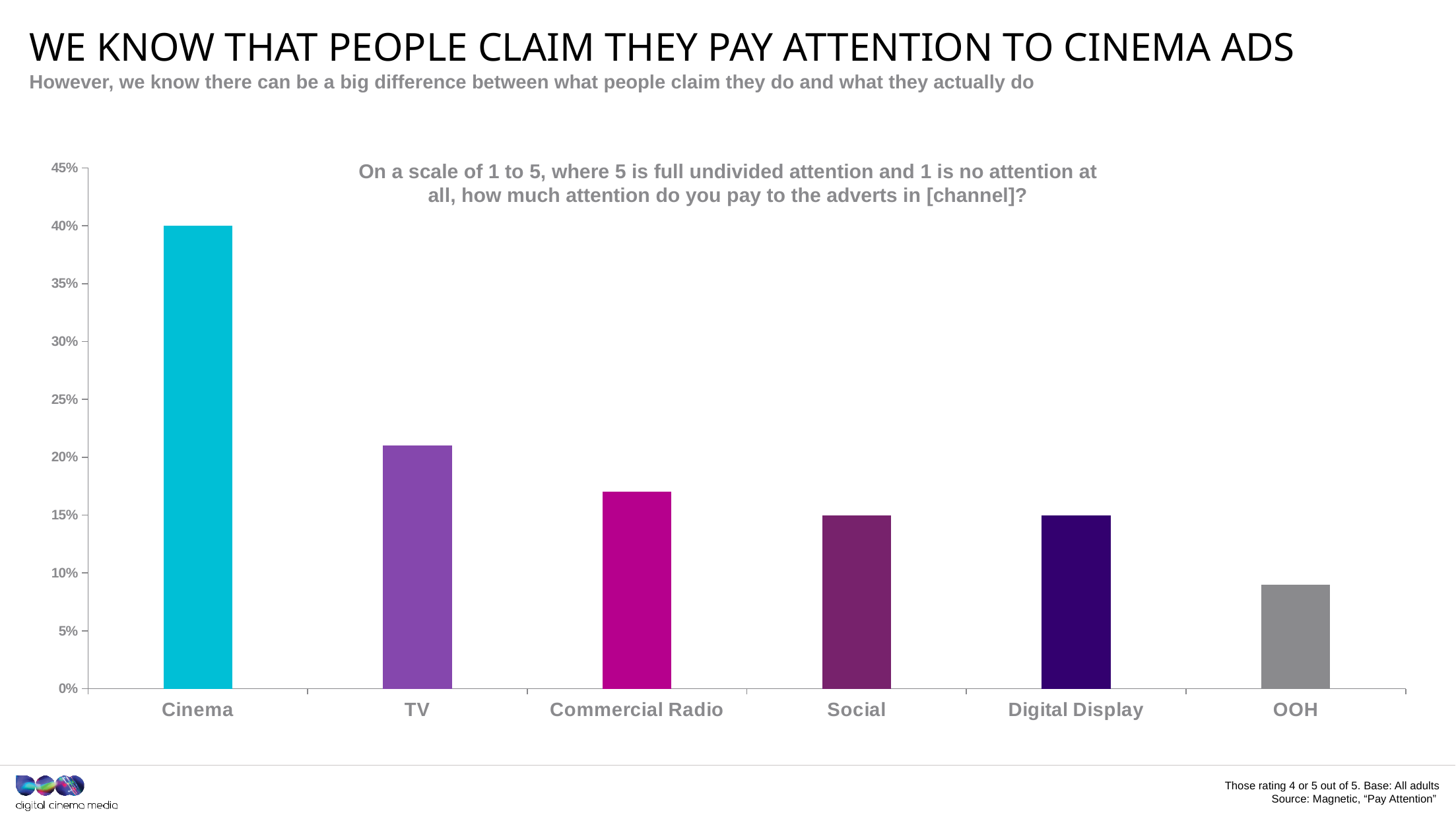
What kind of chart is shown on the slide? bar chart Which is larger, the value for TV or the value for Commercial Radio? TV Is the value for Commercial Radio greater or less than 15%? greater How many channels are plotted on the chart? 6 Which is larger, the value for Cinema or the value for TV? Cinema What is the value for Cinema? 40% Which channel has the highest value on the chart? Cinema Is the value for OOH greater or less than 10%? less Is the value for TV greater or less than 20%? greater Which channel has the lowest value on the chart? OOH Do the values generally rise or fall moving from left to right across the channels? fall What is the highest value shown on the vertical axis? 45%